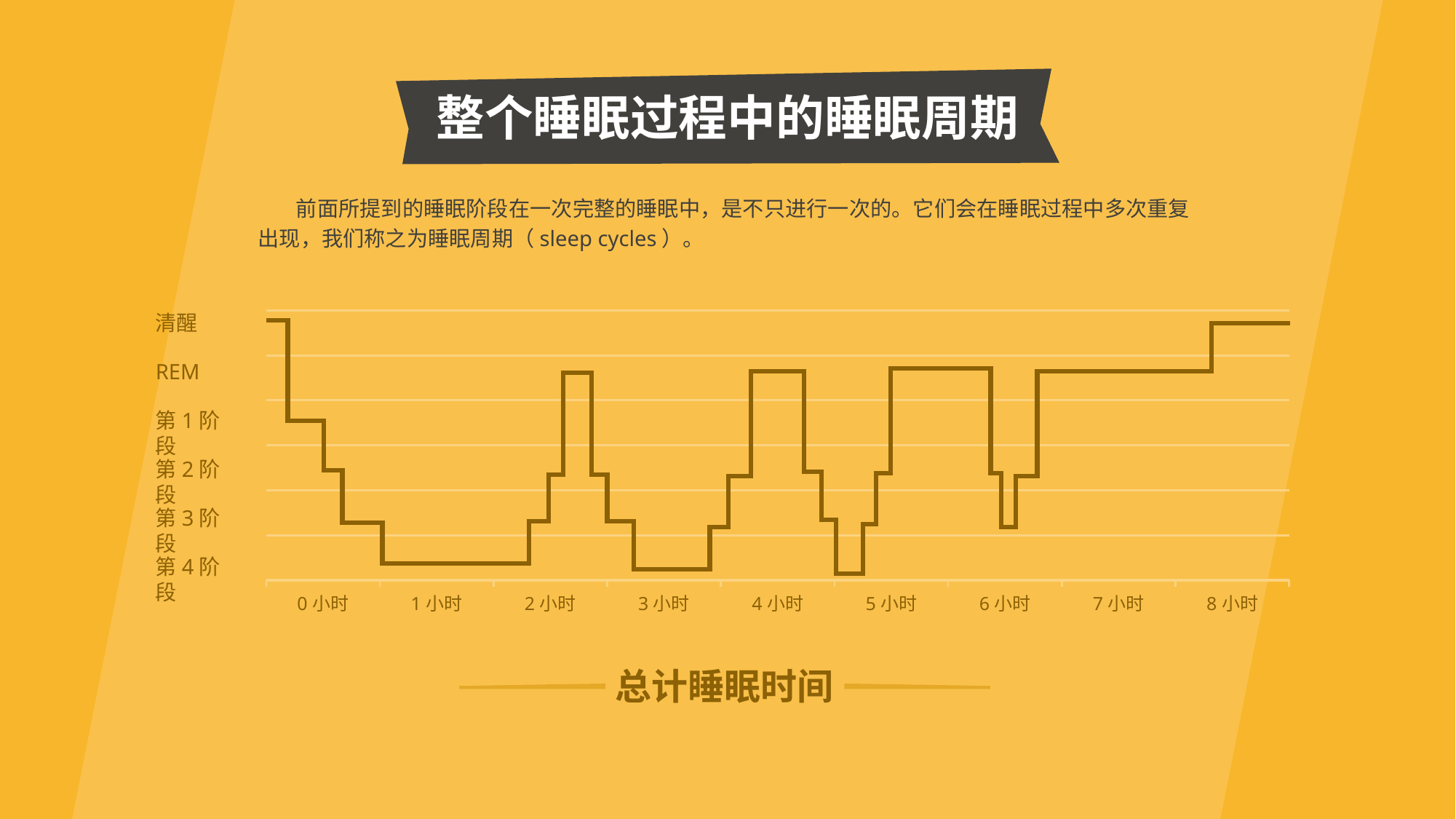
What kind of chart is shown on the slide? line chart Which sleep stage is the line at 7 小时? REM Which sleep stage is the line at 4 小时? REM What is the deepest sleep stage the line reaches on the chart? 第 4 阶段 How many hour ticks are labelled on the x axis of the chart? 9 How many sleep stage categories are labelled on the y axis of the chart? 6 Which sleep stage is the line at when the chart ends at 8 小时? 清醒 Which sleep stage is the line at 1 小时? 第 4 阶段 Which sleep stage is the line at when the chart begins at 0 小时? 清醒 What is the title of the chart on the slide? 整个睡眠过程中的睡眠周期 Which sleep stage is the line at 3 小时? 第 4 阶段 What is the label shown beneath the x axis of the chart? 总计睡眠时间